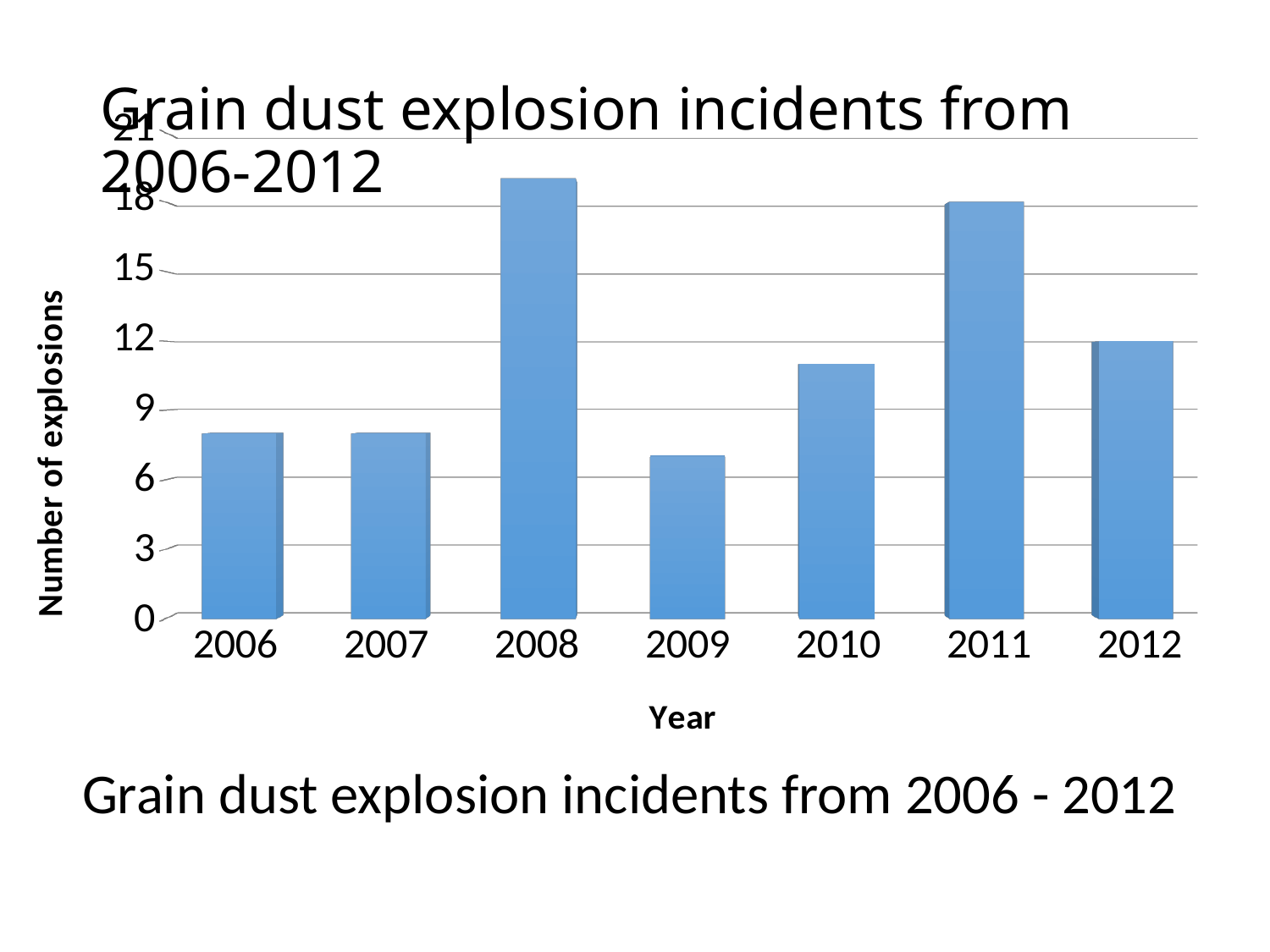
What kind of chart is shown on the slide? bar chart Is the value for 2010 greater or less than 9? greater Which year has the lowest number of explosions? 2009 Which year has more explosions, 2008 or 2010? 2008 What is the label on the vertical axis of the chart? Number of explosions Is the value for 2008 greater or less than 18? greater Is the value for 2009 greater or less than 9? less Which year has the highest number of explosions? 2008 What is the number of explosions for 2011? 18 How many years are shown on the x axis of the chart? 7 Do the values rise or fall from 2009 to 2011? rise What is the number of explosions for 2012? 12